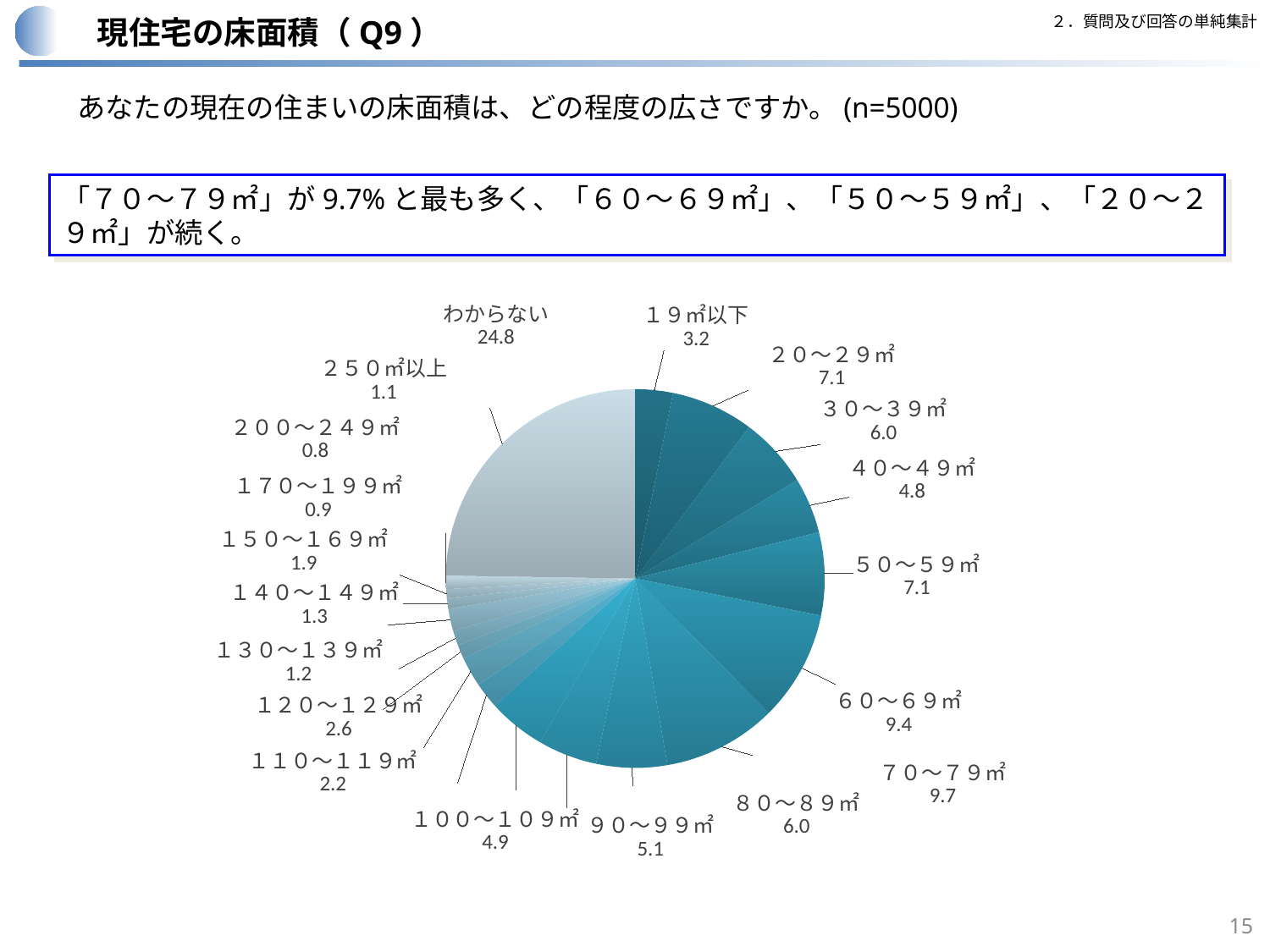
Which is larger, the value for 「２０～２９㎡」 or the value for 「３０～３９㎡」? ２０～２９㎡ How many categories are shown in the pie chart? 19 What is the sample size (n) stated for the question on the slide? 5000 What is the difference between the values for 「７０～７９㎡」 and 「６０～６９㎡」? 0.3 What is the value shown for 「１００～１０９㎡」? 4.9 Which category has the smallest slice of the pie? ２００～２４９㎡ What is the value shown for 「７０～７９㎡」? 9.7 What is the value shown for 「２５０㎡以上」? 1.1 Which is larger, the value for 「１２０～１２９㎡」 or the value for 「１１０～１１９㎡」? １２０～１２９㎡ What is the value shown for 「わからない」? 24.8 Which category has the largest slice of the pie? わからない What kind of chart is shown on the slide? pie chart